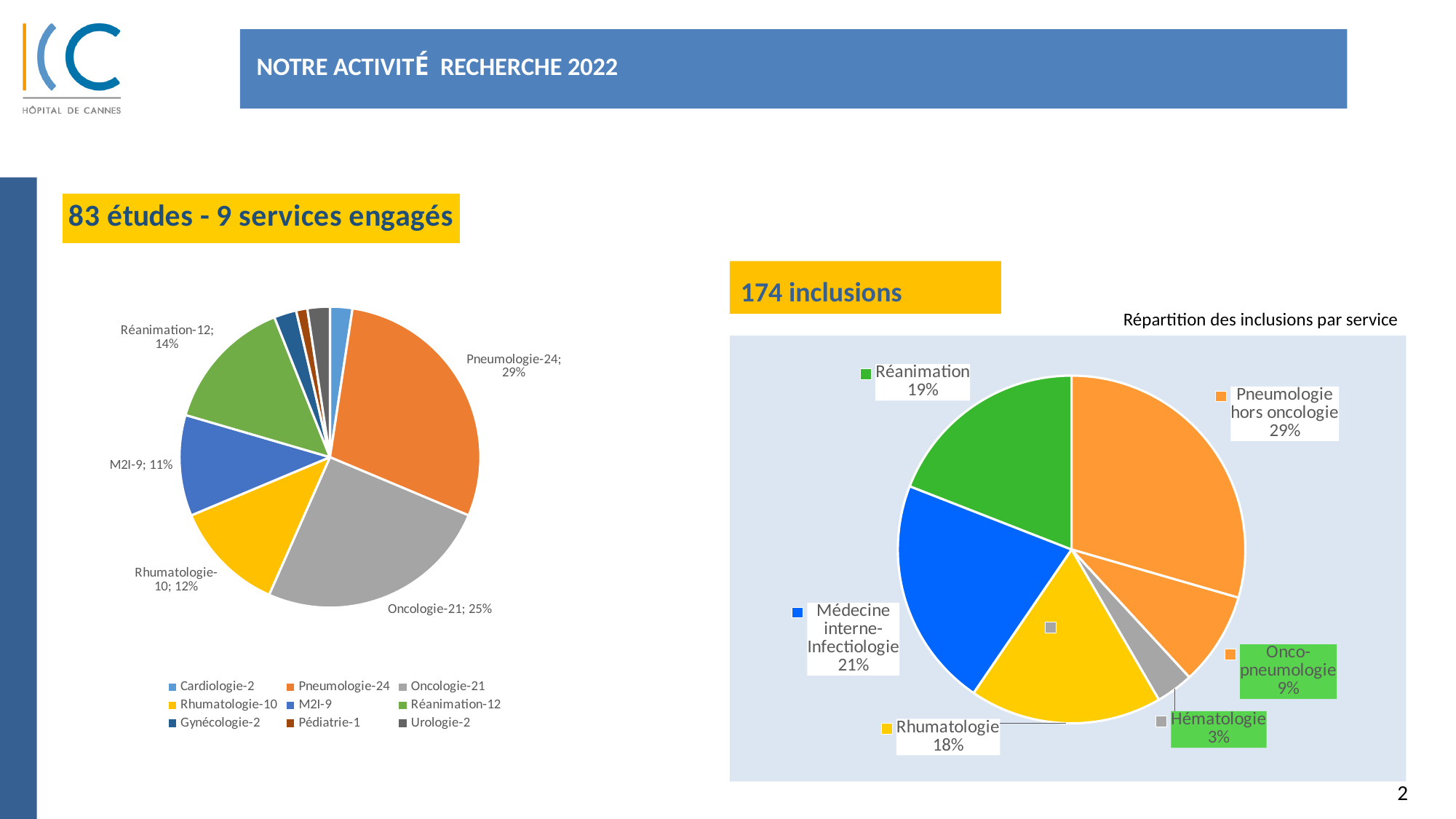
What kind of chart is the left chart under '83 études - 9 services engagés'? pie chart In the left pie chart (83 études), what is the difference in number of studies between Pneumologie-24 and Oncologie-21? 3 In the left pie chart (83 études), how many services does the legend list? 9 In the right pie chart 'Répartition des inclusions par service', what share is shown for Médecine interne-Infectiologie? 21% In the left pie chart (83 études), what percentage is shown for Oncologie-21? 25% In the right pie chart 'Répartition des inclusions par service', how many slices are there? 6 In the left pie chart (83 études), which has more studies, Réanimation or Rhumatologie? Réanimation In the left pie chart (83 études), how many studies does the legend give for Pneumologie? 24 In the left pie chart (83 études), which service has the largest slice? Pneumologie-24 In the right pie chart 'Répartition des inclusions par service', which service has the largest share? Pneumologie hors oncologie In the left pie chart (83 études), which service has the smallest number of studies in the legend? Pédiatrie-1 In the right pie chart 'Répartition des inclusions par service', which service has the smallest share? Hématologie